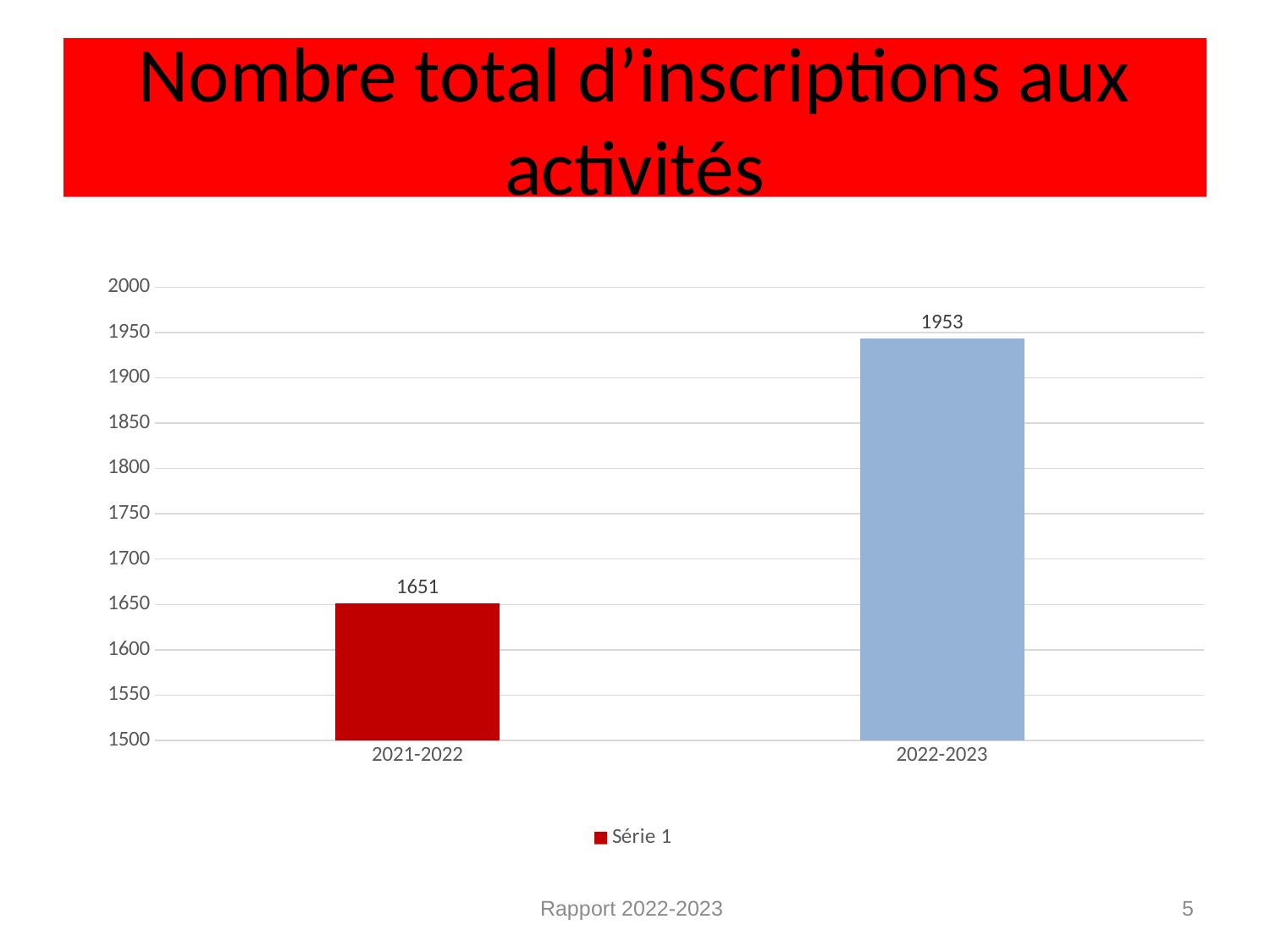
What is the value for 2021-2022? 1651 Which is larger, the value for 2021-2022 or the value for 2022-2023? 2022-2023 Is the value for 2022-2023 greater or less than 1900? greater What is the difference between the values for 2022-2023 and 2021-2022? 302 Which category has the highest value? 2022-2023 Do the values rise or fall from 2021-2022 to 2022-2023? rise What is the value for 2022-2023? 1953 Is the value for 2021-2022 greater or less than 1700? less Which category has the lowest value? 2021-2022 What kind of chart is shown on the slide? bar chart How many categories are shown on the x axis? 2 How many series does the legend list? 1